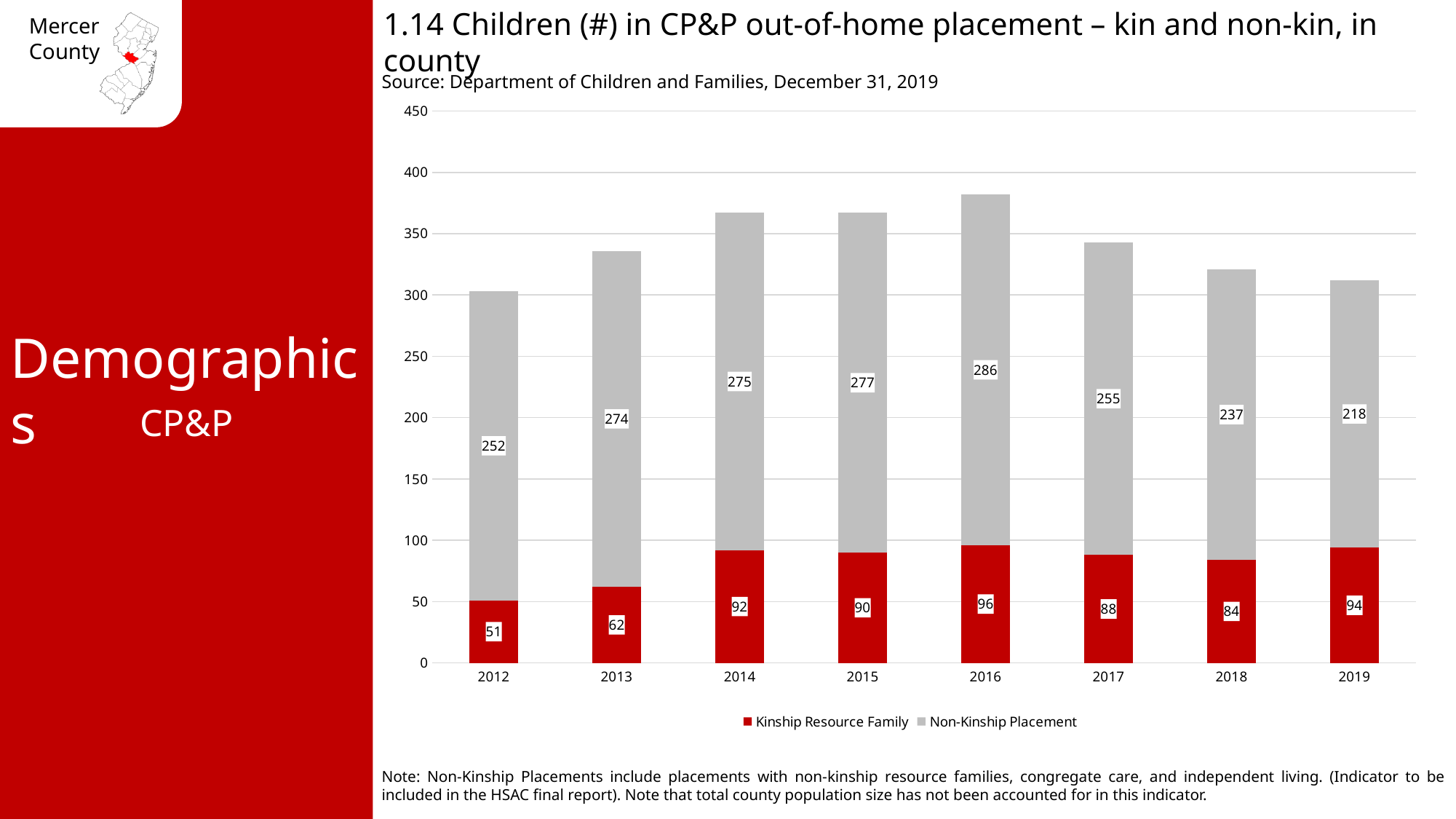
How many series does the legend list? 2 What is the difference between the Non-Kinship Placement values for 2013 and 2019? 56 Which is larger, the Kinship Resource Family value for 2017 or for 2018? 2017 What is the Kinship Resource Family value for 2014? 92 Which year has the lowest Kinship Resource Family value? 2012 Which colour represents Kinship Resource Family in the chart? Red How many years are shown on the x axis? 8 Is the total of the stacked bar for 2012 greater or less than 350? less What is the Non-Kinship Placement value for 2019? 218 What is the total of the stacked bar for 2016? 382 Which year has the highest Non-Kinship Placement value? 2016 What type of chart is shown on the slide? Stacked bar chart